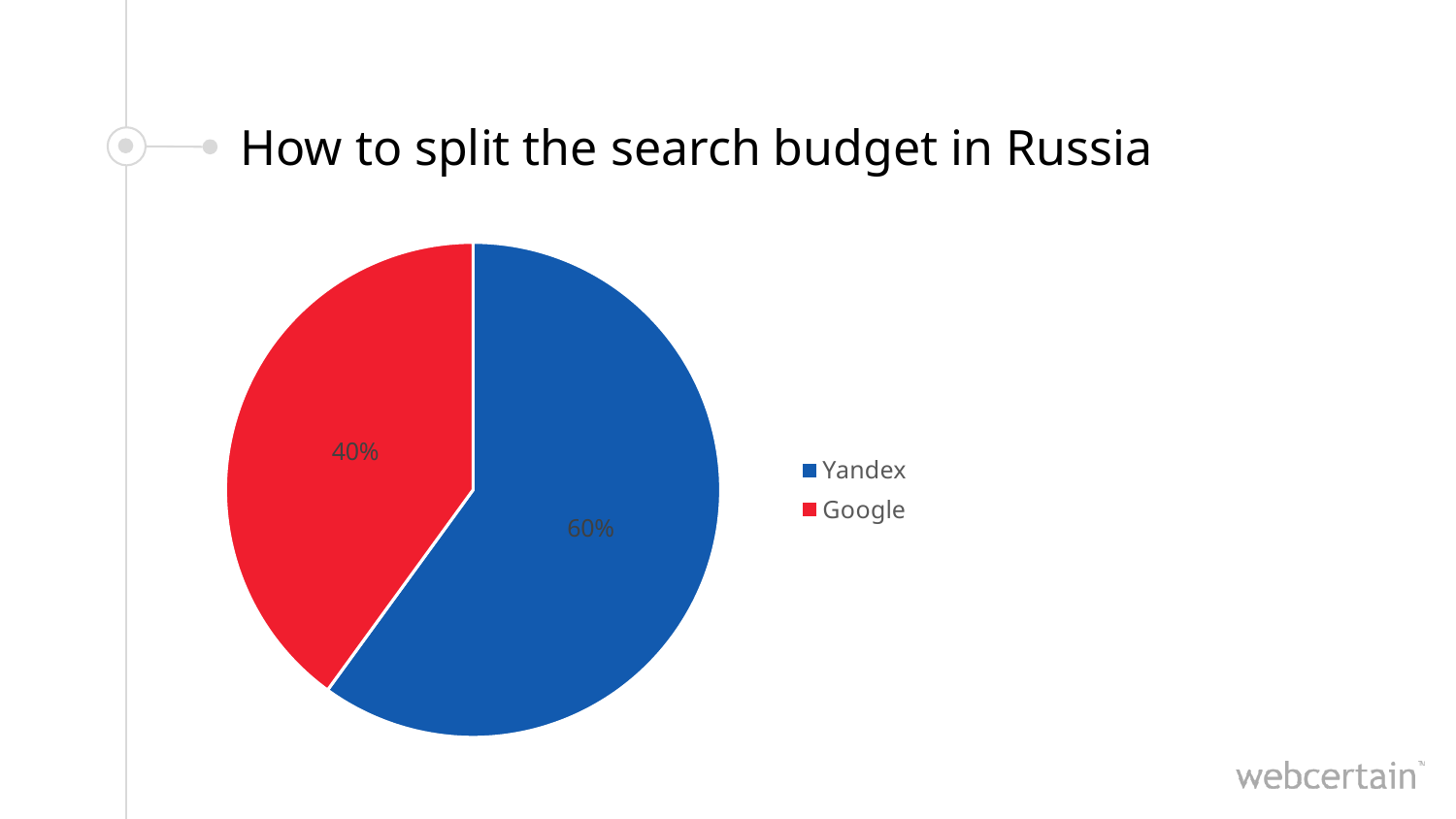
Which has a larger share of the budget, Google or Yandex? Yandex How many entries does the legend list? 2 What is the difference in percentage points between the Yandex and Google shares? 20 What is the share of the pie taken by the Google slice? 40% Which search engine has the largest share of the budget? Yandex What share of the search budget does Yandex receive? 60% Which search engine has the smallest share of the budget? Google What colour is the Yandex slice? Blue What share of the search budget does Google receive? 40% What is the title of the slide? How to split the search budget in Russia What kind of chart is shown on the slide? Pie chart How many slices does the pie chart have? 2